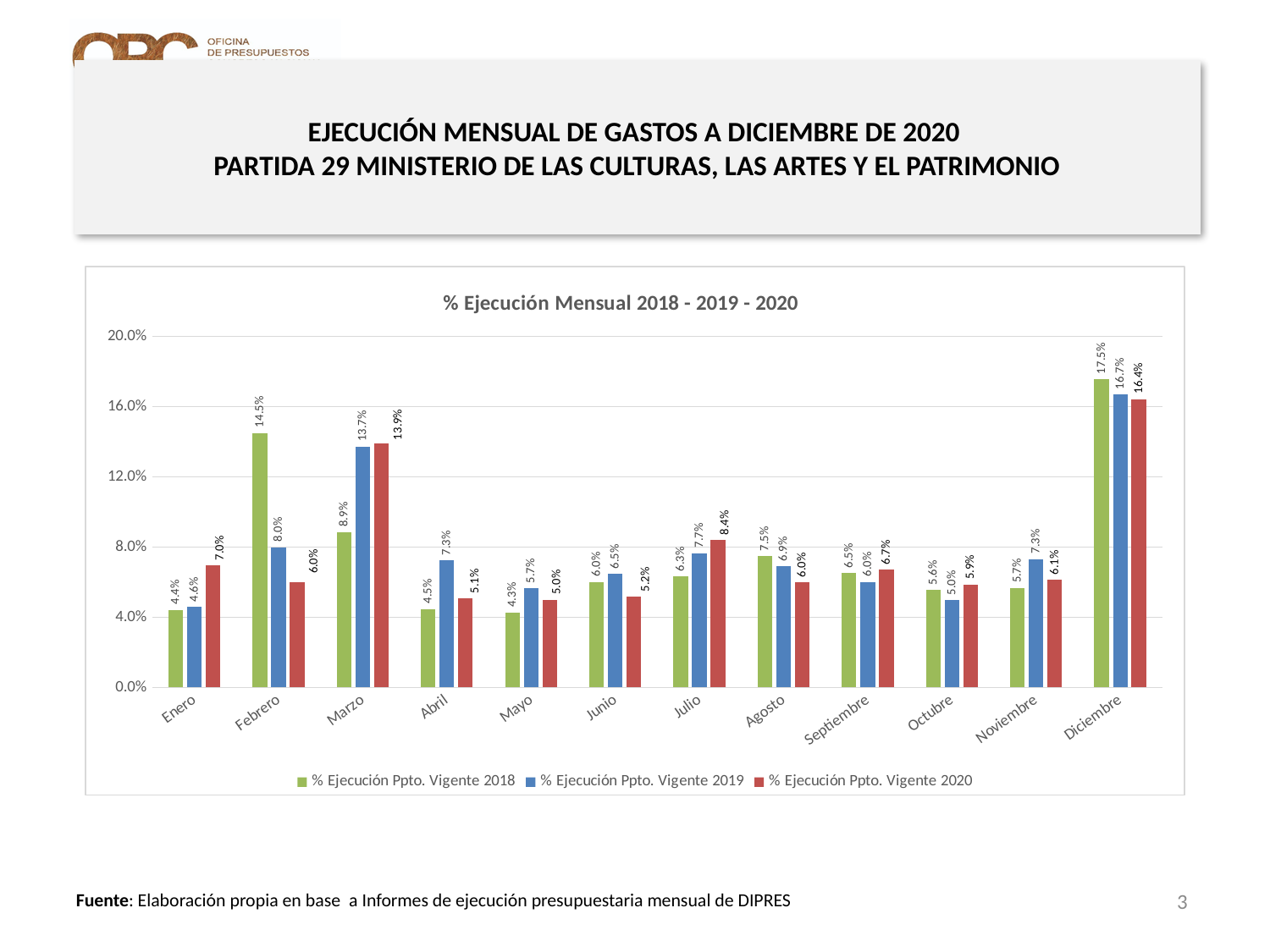
What is the value for % Ejecución Ppto. Vigente 2018 in Febrero? 14.5% What is the value for % Ejecución Ppto. Vigente 2020 in Enero? 7.0% What is the value for % Ejecución Ppto. Vigente 2019 in Marzo? 13.7% Which month has the highest value for % Ejecución Ppto. Vigente 2018? Diciembre What kind of chart is shown? Bar chart Which month has the lowest value for % Ejecución Ppto. Vigente 2018? Mayo What is the difference between the 2018 and 2019 values in Febrero? 6.5% How many months are shown on the x axis? 12 In Abril, which is larger: the 2019 value or the 2020 value? 2019 value What is the title of the chart? % Ejecución Mensual 2018 - 2019 - 2020 How many series does the legend list? 3 Is the value for % Ejecución Ppto. Vigente 2018 in Diciembre greater or less than 16.0%? greater